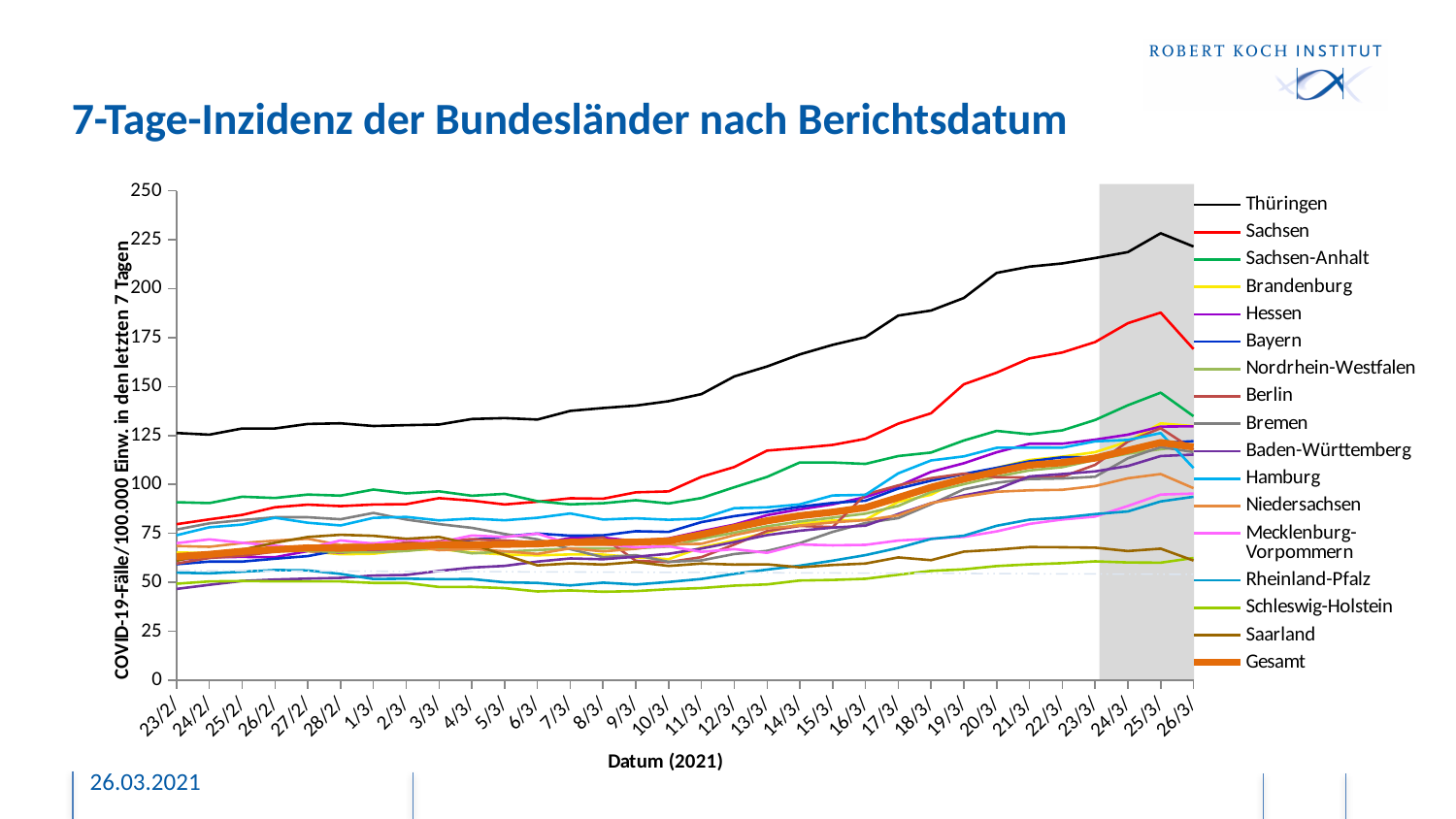
How many series does the legend list? 17 Is the value for Gesamt on 26/3 greater or less than 100? greater Does the Thüringen line generally rise or fall from 23/2 to 26/3? rise Is the value for Schleswig-Holstein on 26/3 greater or less than 75? less How many dates are shown on the x axis? 32 Which Bundesland has the highest 7-day incidence on 26/3? Thüringen Which series has the highest value across the whole period shown? Thüringen What kind of chart is shown on the slide? line chart Is the value for Thüringen on 26/3 greater or less than 200? greater What is the label of the y axis? COVID-19-Fälle/100.000 Einw. in den letzten 7 Tagen Which is larger on 25/3, the value for Sachsen or the value for Sachsen-Anhalt? Sachsen